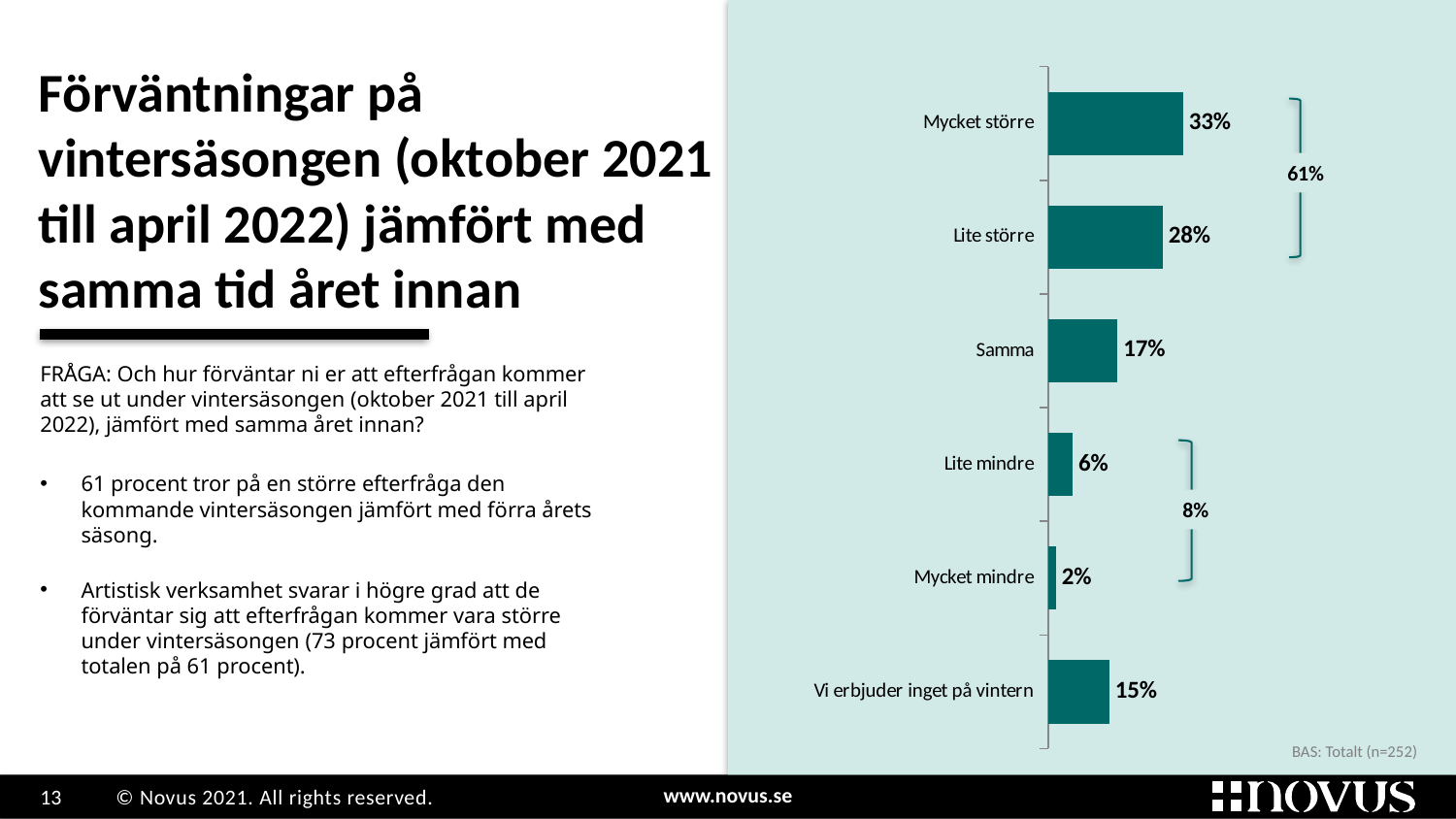
What combined percentage is shown by the bracket grouping "Lite mindre" and "Mycket mindre"? 8% What combined percentage is shown by the bracket grouping "Mycket större" and "Lite större"? 61% Which category has the lowest value? Mycket mindre What is the value for "Mycket större"? 33% What is the difference between "Lite mindre" and "Mycket mindre"? 4% Which category has the highest value? Mycket större How many categories are shown in the chart? 6 Which is larger, "Samma" or "Vi erbjuder inget på vintern"? Samma What is the difference between "Mycket större" and "Lite större"? 5% What kind of chart is shown on the slide? Bar chart What is the value for "Samma"? 17% What is the value for "Vi erbjuder inget på vintern"? 15%